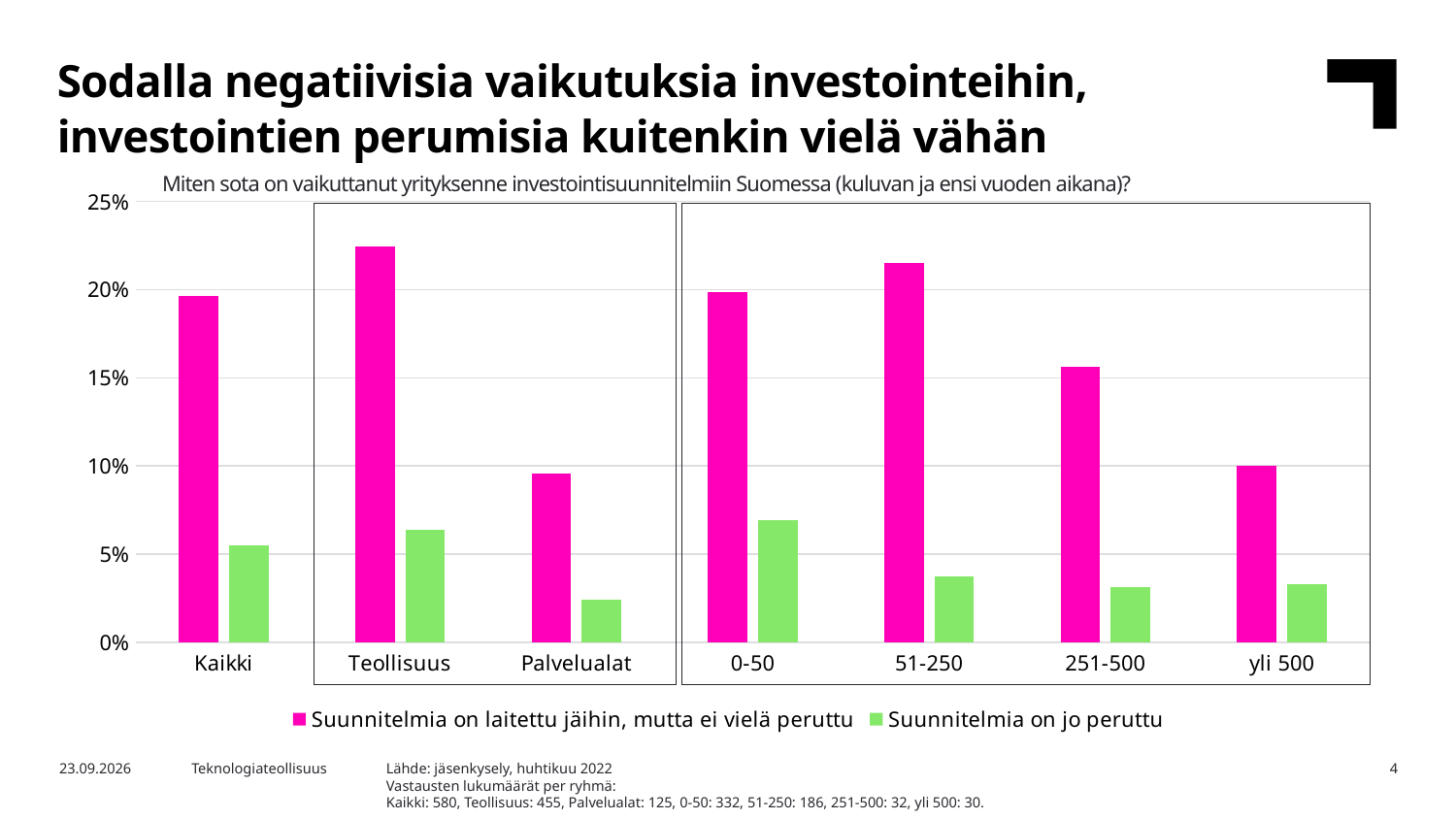
Is the value for 251-500 in the series 'Suunnitelmia on laitettu jäihin, mutta ei vielä peruttu' greater or less than 15%? greater Is the value for 0-50 in the series 'Suunnitelmia on jo peruttu' greater or less than 5%? greater Which category has the lowest value for 'Suunnitelmia on jo peruttu'? Palvelualat What kind of chart is shown on the slide? bar chart Is the value for 51-250 in the series 'Suunnitelmia on jo peruttu' greater or less than 5%? less How many categories are shown on the x axis? 7 Which category has the highest value for 'Suunnitelmia on laitettu jäihin, mutta ei vielä peruttu'? Teollisuus How many series does the legend list? 2 What colour are the bars for the series 'Suunnitelmia on jo peruttu'? green In the series 'Suunnitelmia on laitettu jäihin, mutta ei vielä peruttu', which is larger: Teollisuus or Palvelualat? Teollisuus